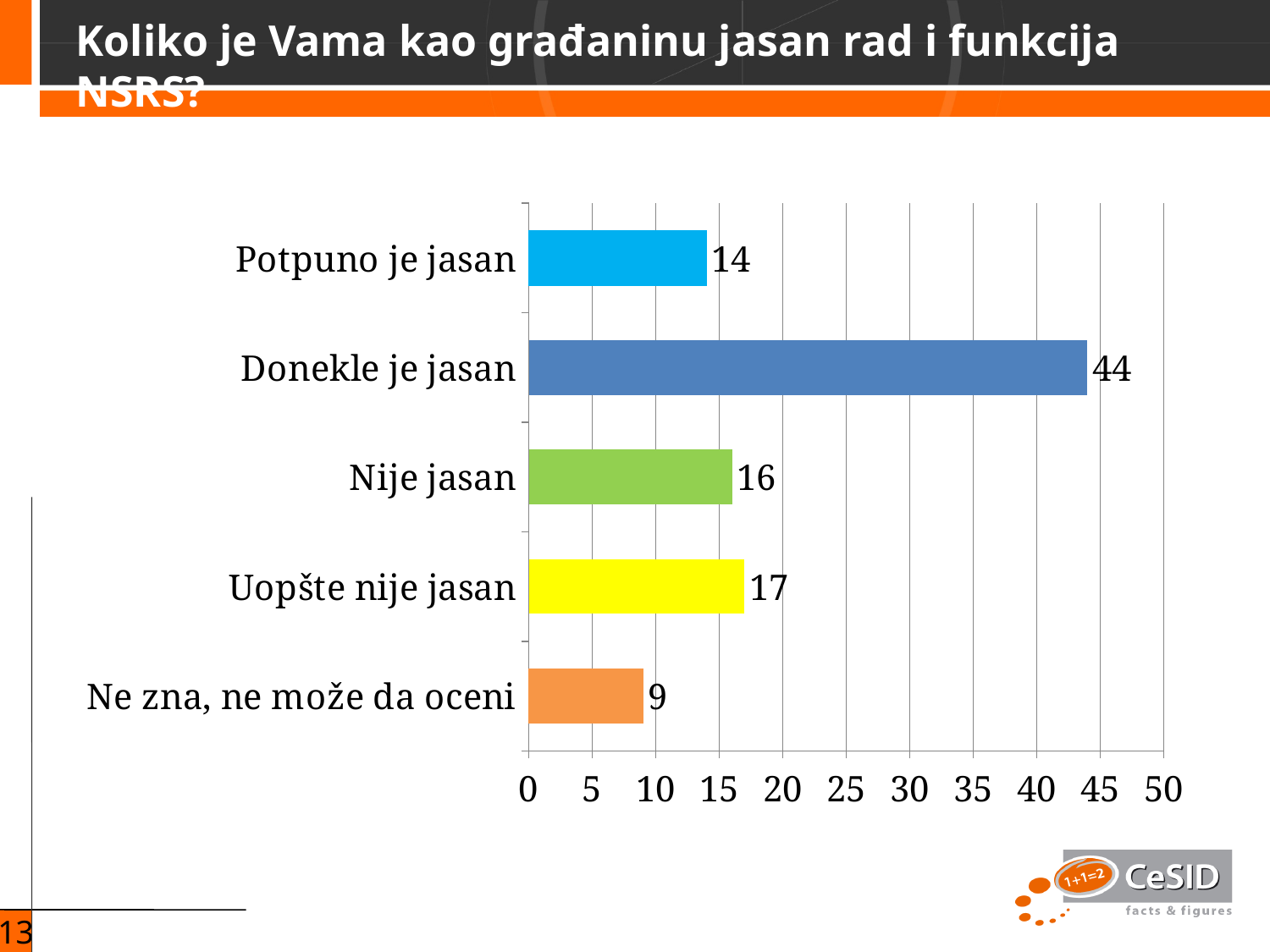
What is the value for "Potpuno je jasan"? 14 What colour is the bar for "Uopšte nije jasan"? yellow Which category has the highest value? Donekle je jasan What is the difference between the values for "Donekle je jasan" and "Uopšte nije jasan"? 27 Which category has the lowest value? Ne zna, ne može da oceni How many categories are shown in the chart? 5 Is the value for "Donekle je jasan" greater or less than 40? greater What kind of chart is shown on the slide? bar chart What is the value for "Donekle je jasan"? 44 Which is larger, the value for "Nije jasan" or the value for "Potpuno je jasan"? Nije jasan What is the highest value shown on the x axis? 50 What is the value for "Ne zna, ne može da oceni"? 9